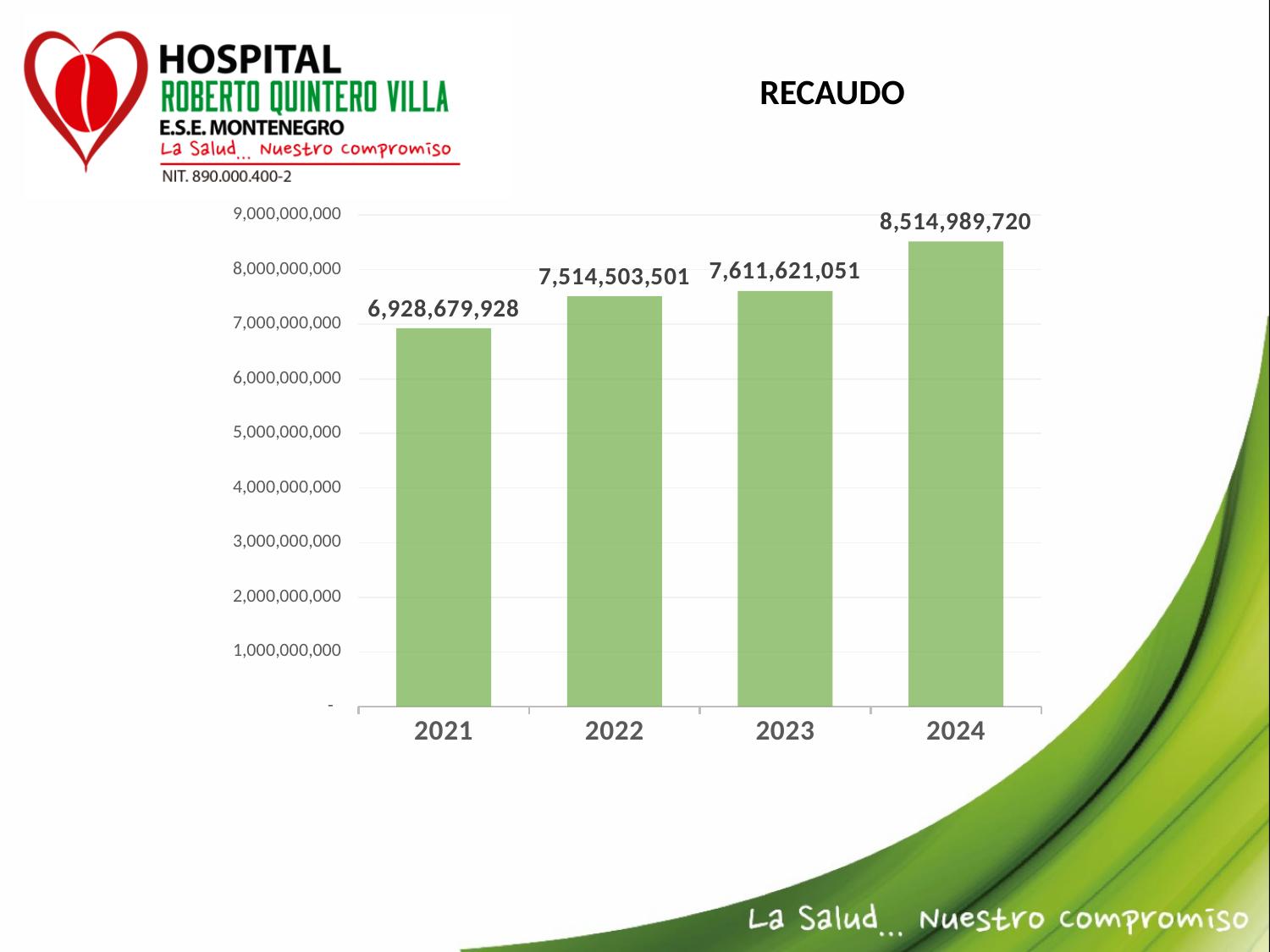
What kind of chart is shown? bar chart Which is larger, the value for 2022 or the value for 2023? 2023 What is the difference between the values for 2024 and 2021? 1,586,309,792 What is the value for 2021? 6,928,679,928 What is the difference between the values for 2023 and 2022? 97,117,550 What is the value for 2022? 7,514,503,501 How many years are shown on the x axis? 4 Which year has the highest value? 2024 Do the values rise or fall from 2021 to 2024? rise Is the value for 2023 greater or less than 8,000,000,000? less What is the value for 2024? 8,514,989,720 Which year has the lowest value? 2021